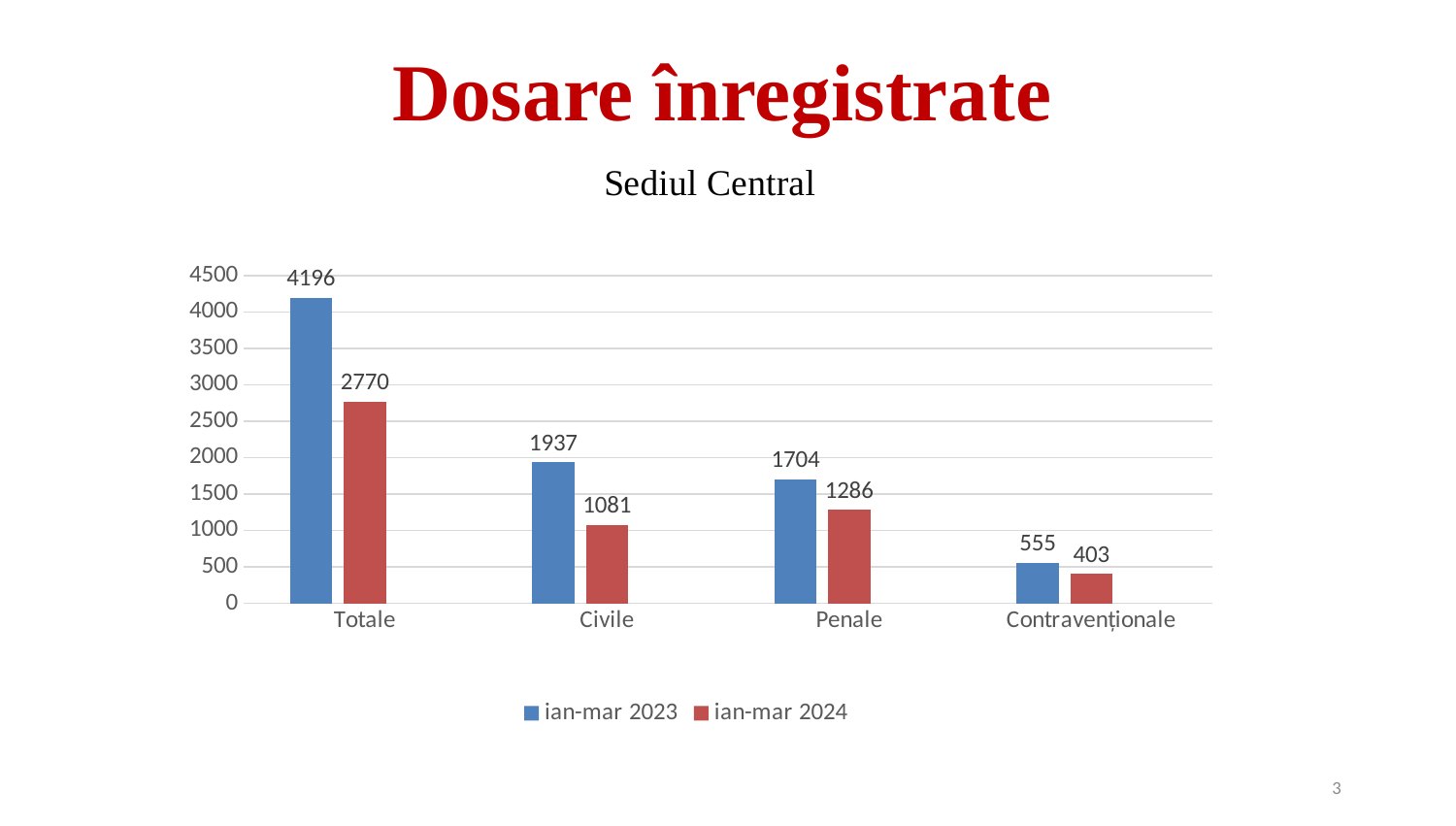
Which category has the lowest value in the ian-mar 2024 series? Contravenționale What is the value for Penale in the ian-mar 2023 series? 1704 What is the value for Civile in the ian-mar 2024 series? 1081 What kind of chart is shown on the slide? Bar chart What is the value for Contravenționale in the ian-mar 2024 series? 403 Which is larger for Civile: the ian-mar 2023 value or the ian-mar 2024 value? ian-mar 2023 How many series does the legend list? 2 What is the difference between the ian-mar 2023 and ian-mar 2024 values for Totale? 1426 Which category has the highest value in the ian-mar 2023 series? Totale What is the difference between the ian-mar 2023 and ian-mar 2024 values for Penale? 418 How many categories are shown on the x axis? 4 What is the value for Totale in the ian-mar 2023 series? 4196